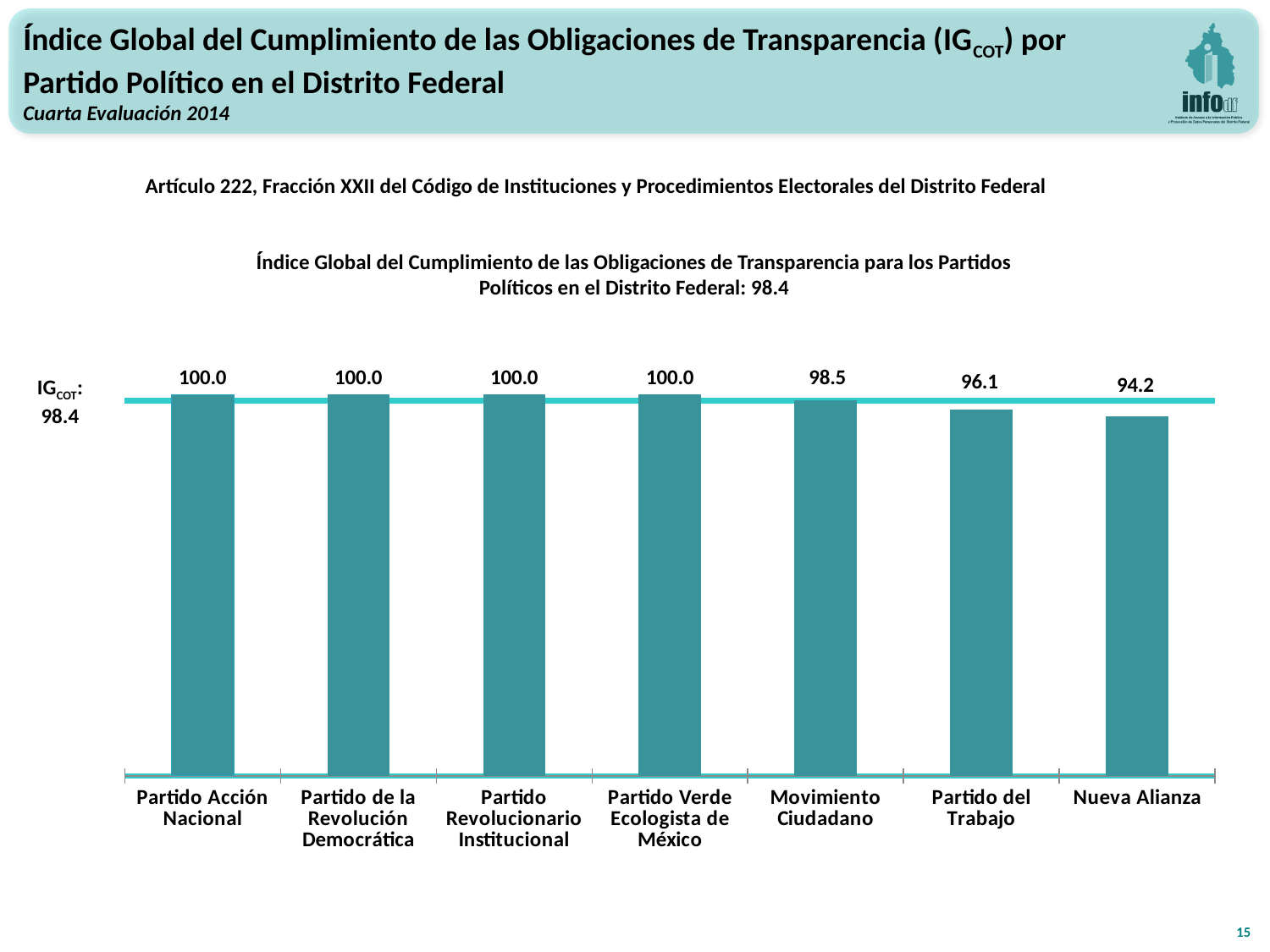
Which party has the lowest value? Nueva Alianza How many parties are shown in the chart? 7 What is the value for Partido del Trabajo? 96.1 Which is larger, the value for Partido del Trabajo or the value for Nueva Alianza? Partido del Trabajo What is the difference between the values for Partido Verde Ecologista de México and Partido del Trabajo? 3.9 Do the values rise or fall from left to right across the chart? Fall What is the value for Nueva Alianza? 94.2 What is the difference between the values for Movimiento Ciudadano and Nueva Alianza? 4.3 What value does the horizontal reference line labelled IGCOT represent? 98.4 What is the value for Movimiento Ciudadano? 98.5 What is the value for Partido Acción Nacional? 100.0 What kind of chart is shown on the slide? Bar chart